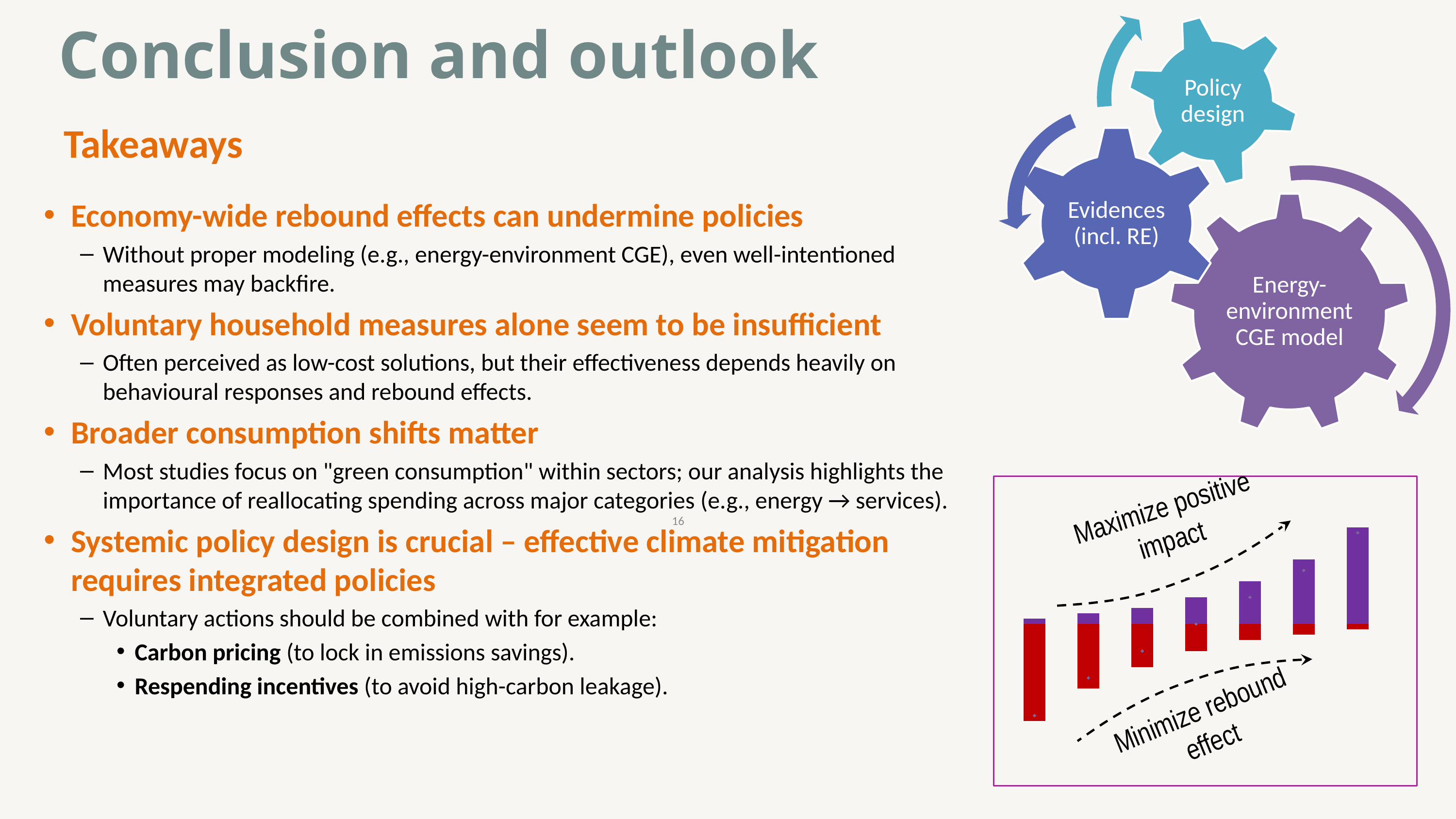
In the bottom-right chart, do the purple (positive) segments of the bars rise or fall from left to right? rise What does the dashed-arrow annotation below the bars in the bottom-right chart say? Minimize rebound effect What does the dashed-arrow annotation above the bars in the bottom-right chart say? Maximize positive impact In the bottom-right chart, which bar has the largest purple segment, the leftmost or the rightmost? the rightmost How many bars are plotted in the chart at the bottom right of the slide? 7 What kind of chart is shown in the box at the bottom right of the slide? bar chart In the bottom-right chart, do the red (negative) segments of the bars get larger or smaller from left to right? smaller In the bottom-right chart, which bar has the largest red segment, the leftmost or the rightmost? the leftmost